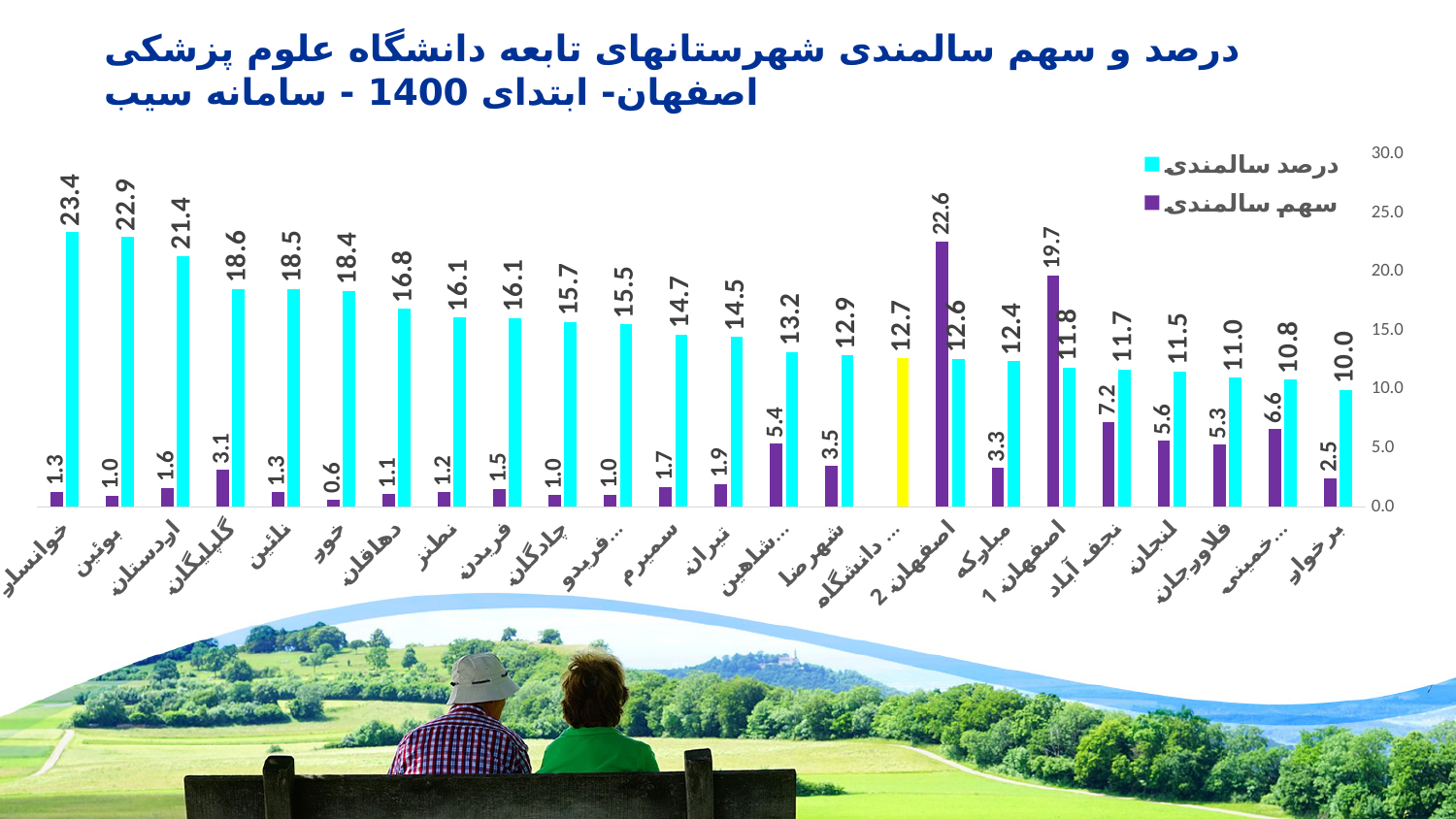
What is the value of سهم سالمندی for نجف آباد? 7.2 Which category has the highest درصد سالمندی? خوانسار Which is larger, the سهم سالمندی for اصفهان 2 or for اصفهان 1? اصفهان 2 What is the value of سهم سالمندی for اصفهان 2? 22.6 How many categories are shown on the x axis? 24 What is the difference between the درصد سالمندی values for خوانسار and برخوار? 13.4 How many series does the legend list? 2 What kind of chart is shown on the slide? bar chart Which category has the lowest درصد سالمندی? برخوار What is the value of درصد سالمندی for خوانسار? 23.4 Which category has the lowest سهم سالمندی? خور Is the درصد سالمندی value for گلپایگان greater or less than 15.0? greater